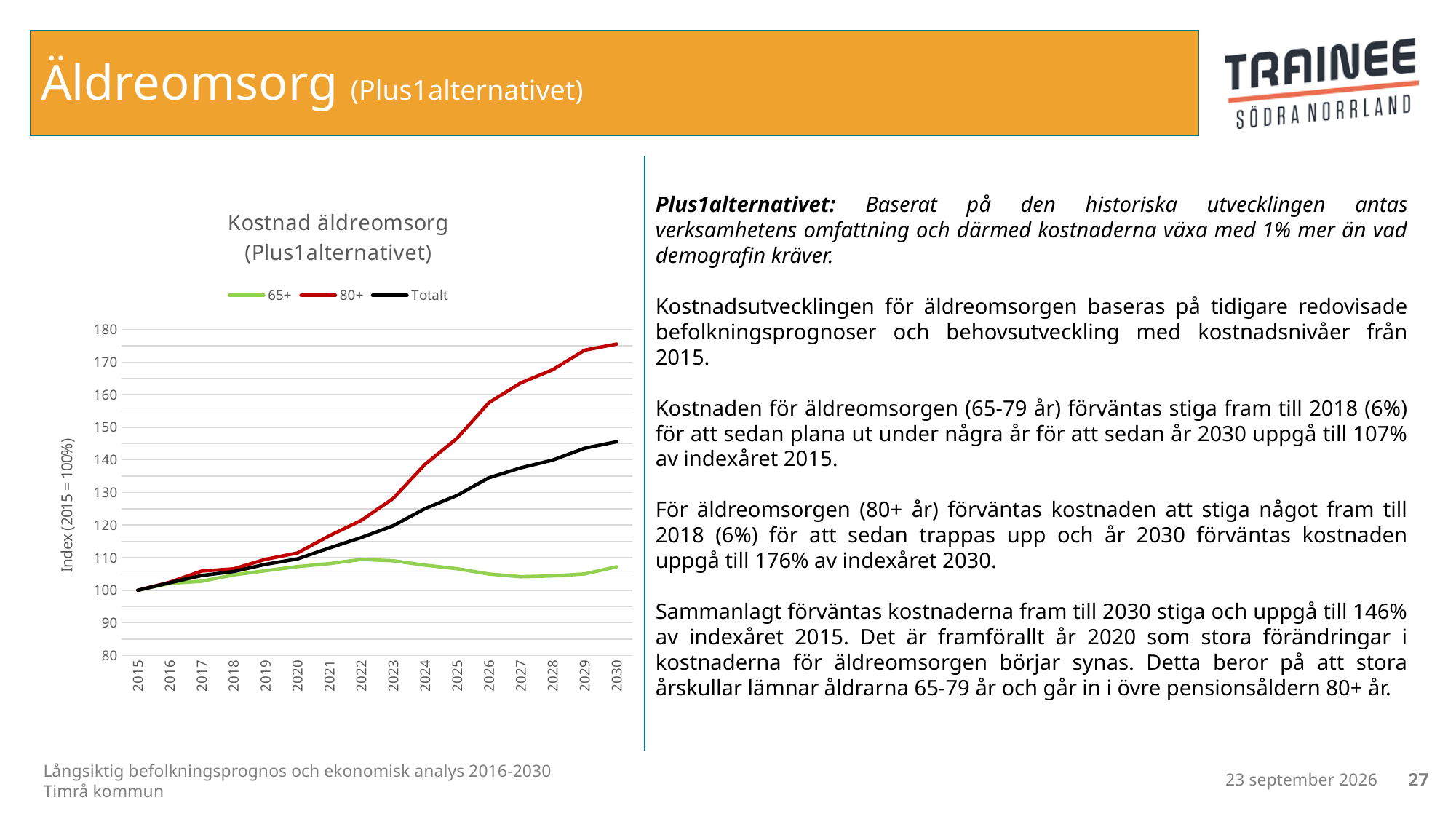
What is the label on the y axis of the chart? Index (2015 = 100%) How many series does the legend of the chart list? 3 Is the value for 80+ in 2025 greater or less than 140? greater What is the index value for all three series in 2015? 100 What kind of chart is shown on the slide? Line chart Is the value for 65+ in 2030 greater or less than 110? less How many years are shown on the x axis of the chart? 16 Does the 80+ series rise or fall from 2015 to 2030? Rise Is the value for Totalt in 2030 greater or less than 140? greater Which series has the lowest value in 2030? 65+ Which series has the highest value in 2030? 80+